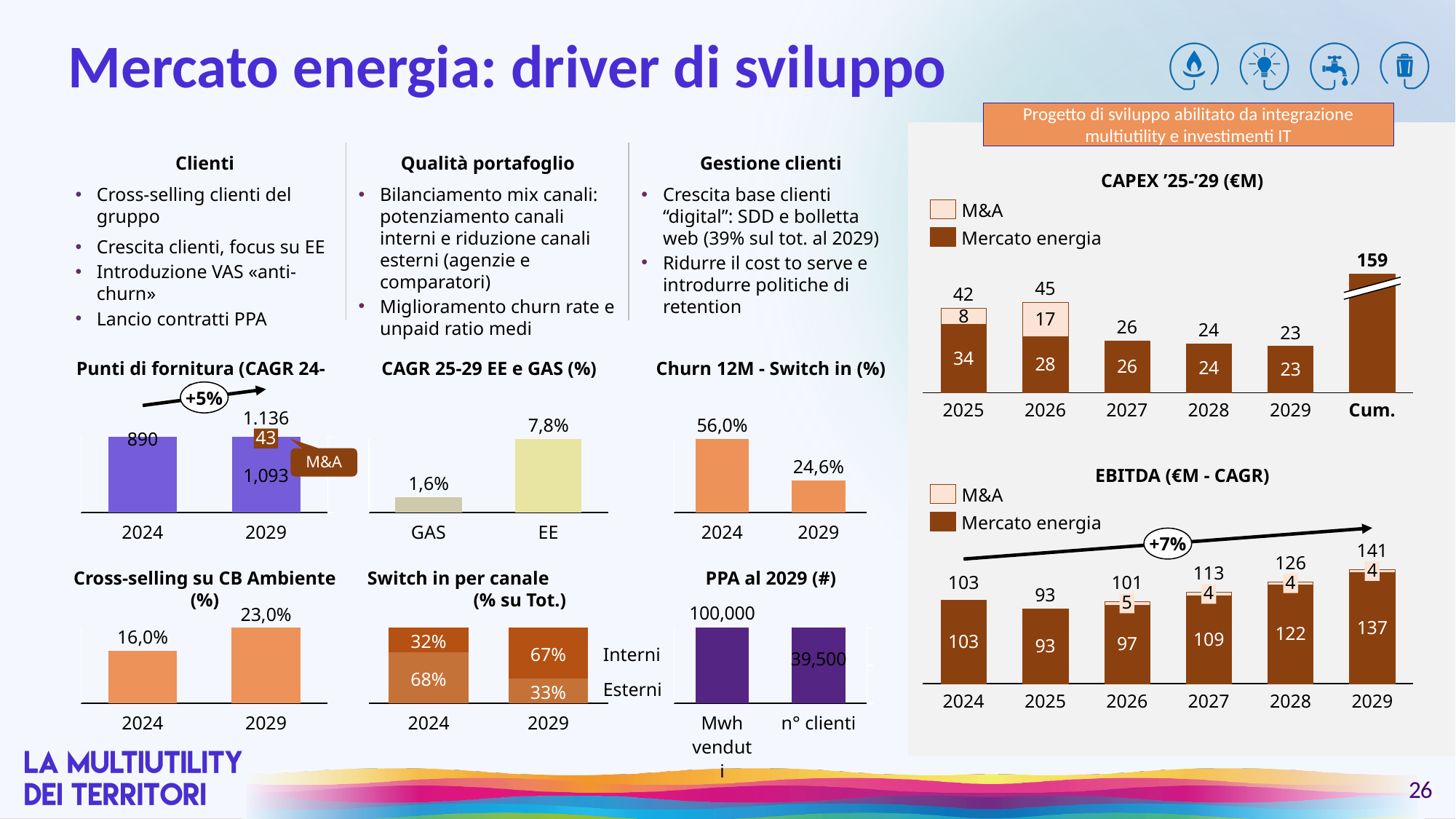
In the EBITDA (€M - CAGR) chart, what is the total for 2028? 126 In the EBITDA (€M - CAGR) chart, how many series does the legend list? 2 In the CAPEX '25-'29 (€M) chart, which year from 2025 to 2029 has the lowest total? 2029 In the CAGR 25-29 EE e GAS (%) chart, what is the value for GAS? 1,6% In the EBITDA (€M - CAGR) chart, what is the Mercato energia value for 2029? 137 In the PPA al 2029 (#) chart, what is the value for n° clienti? 39,500 In the Churn 12M - Switch in (%) chart, which year has the higher value, 2024 or 2029? 2024 In the CAPEX '25-'29 (€M) chart, what is the Mercato energia value for 2026? 28 In the CAPEX '25-'29 (€M) chart, what is the cumulative (Cum.) value? 159 In the EBITDA (€M - CAGR) chart, what is the difference between the 2029 total and the 2024 total? 38 In the Switch in per canale (% su Tot.) chart, what is the Interni share in 2029? 67% In the CAPEX '25-'29 (€M) chart, what is the M&A value for 2025? 8